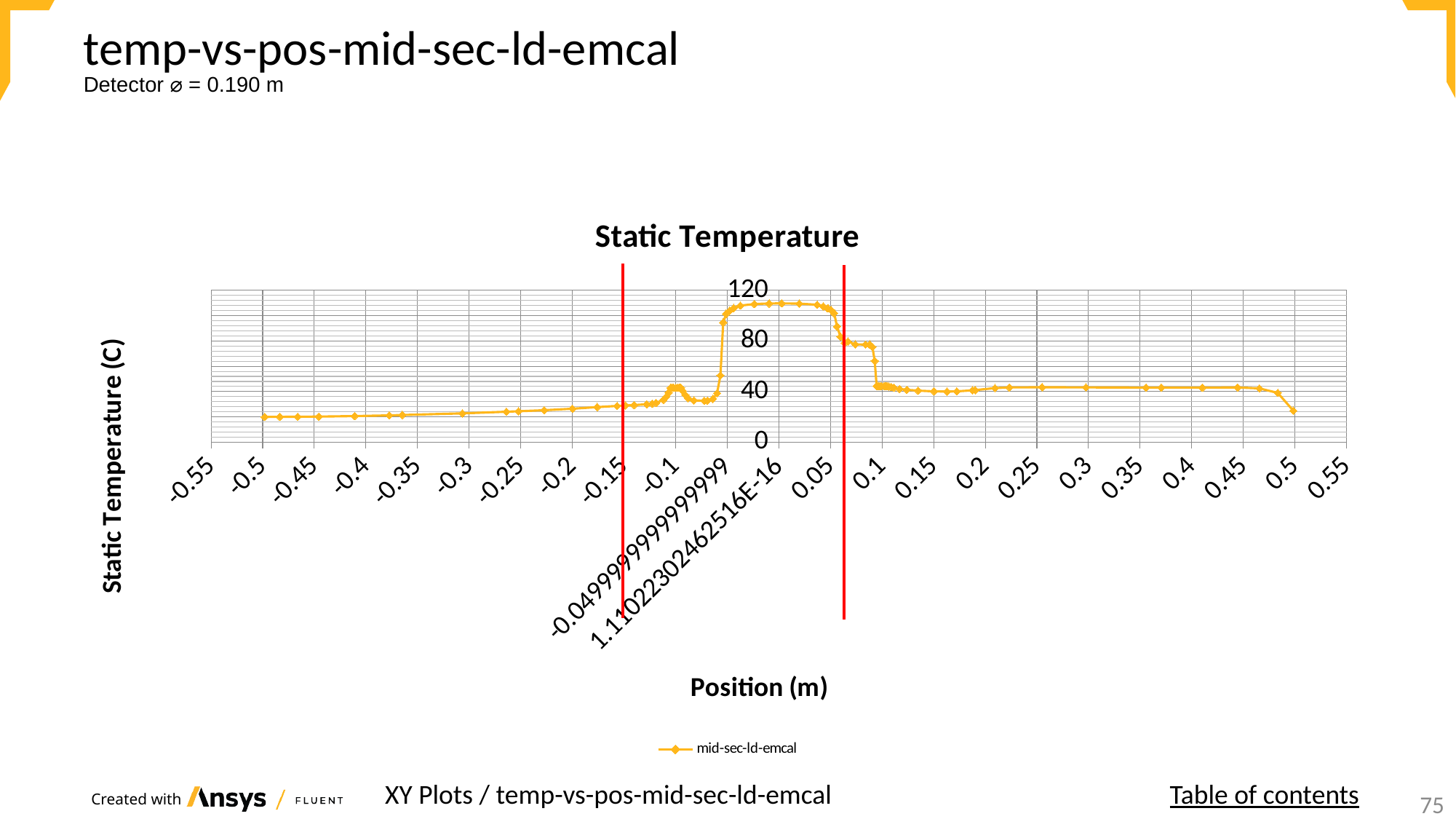
Does the temperature rise or fall as position goes from 0.05 to 0.1? fall What kind of chart is shown on the slide? line chart Is the value at position -0.1 greater or less than 40? greater Is the value at position 0.05 greater or less than 80? greater Is the value at position -0.5 greater or less than 40? less Which is larger, the value at position 0.05 or the value at position -0.5? 0.05 What is the name of the series shown in the legend? mid-sec-ld-emcal Which is larger, the value at position 0.3 or the value at position -0.5? 0.3 How many series does the legend list? 1 What is the title of the chart? Static Temperature